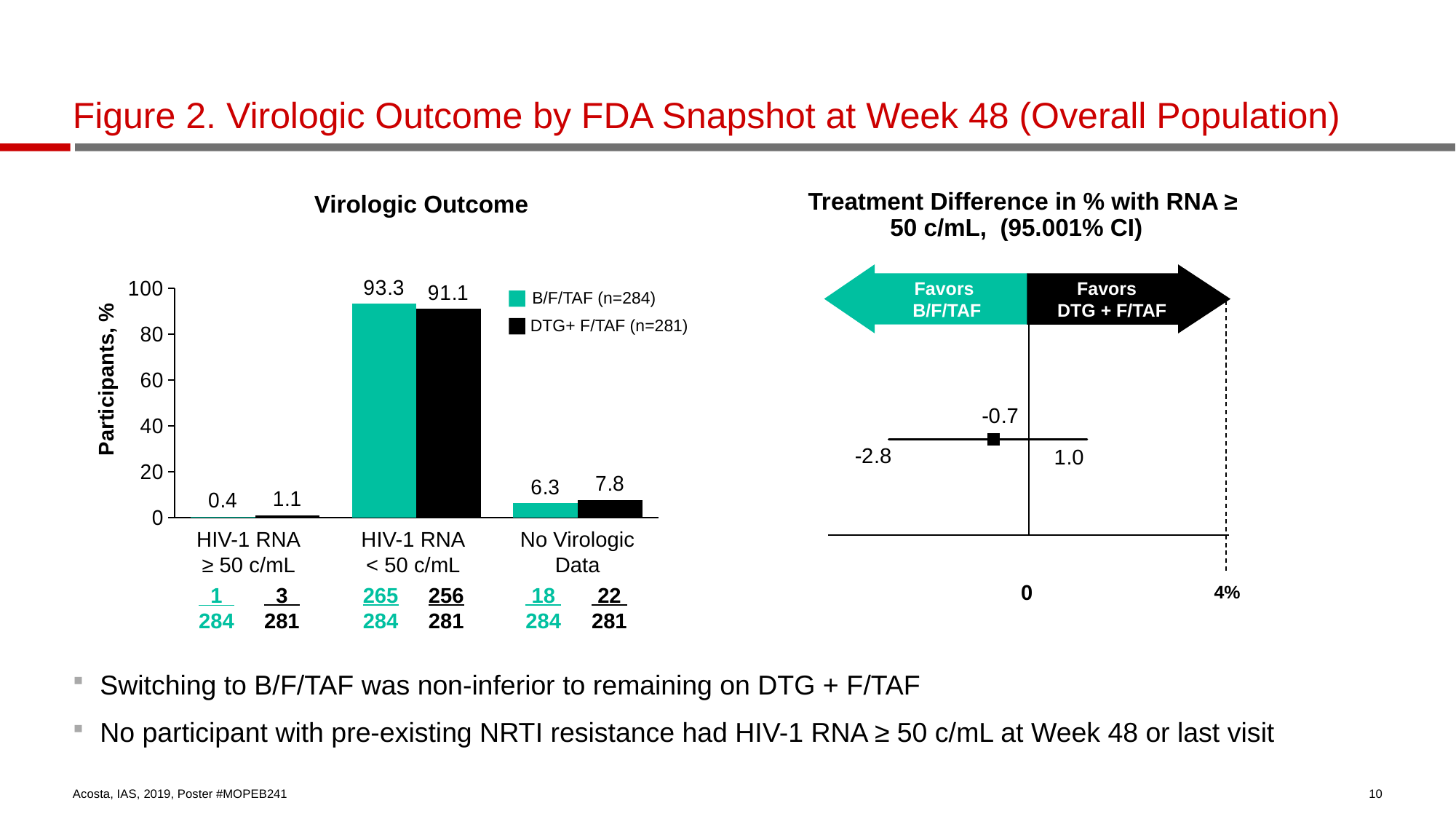
In the Virologic Outcome chart, which series has the larger value for No Virologic Data? DTG+ F/TAF (n=281) In the Treatment Difference chart on the right, what is the point estimate of the treatment difference? -0.7 In the Virologic Outcome chart, what is the difference between the B/F/TAF and DTG + F/TAF values for HIV-1 RNA < 50 c/mL? 2.2 In the Virologic Outcome chart, which category has the highest value for B/F/TAF? HIV-1 RNA < 50 c/mL How many series does the legend of the Virologic Outcome chart list? 2 In the Virologic Outcome chart, which category has the lowest value for DTG + F/TAF? HIV-1 RNA ≥ 50 c/mL In the Virologic Outcome chart, what percentage of DTG + F/TAF participants had No Virologic Data? 7.8 In the Virologic Outcome chart, what percentage of B/F/TAF participants had HIV-1 RNA < 50 c/mL? 93.3 What kind of chart is the Virologic Outcome chart? Bar chart How many categories are shown on the x axis of the Virologic Outcome chart? 3 In the Virologic Outcome chart, what percentage of DTG + F/TAF participants had HIV-1 RNA ≥ 50 c/mL? 1.1 In the Virologic Outcome chart, is the B/F/TAF value for HIV-1 RNA < 50 c/mL greater or less than 80? greater